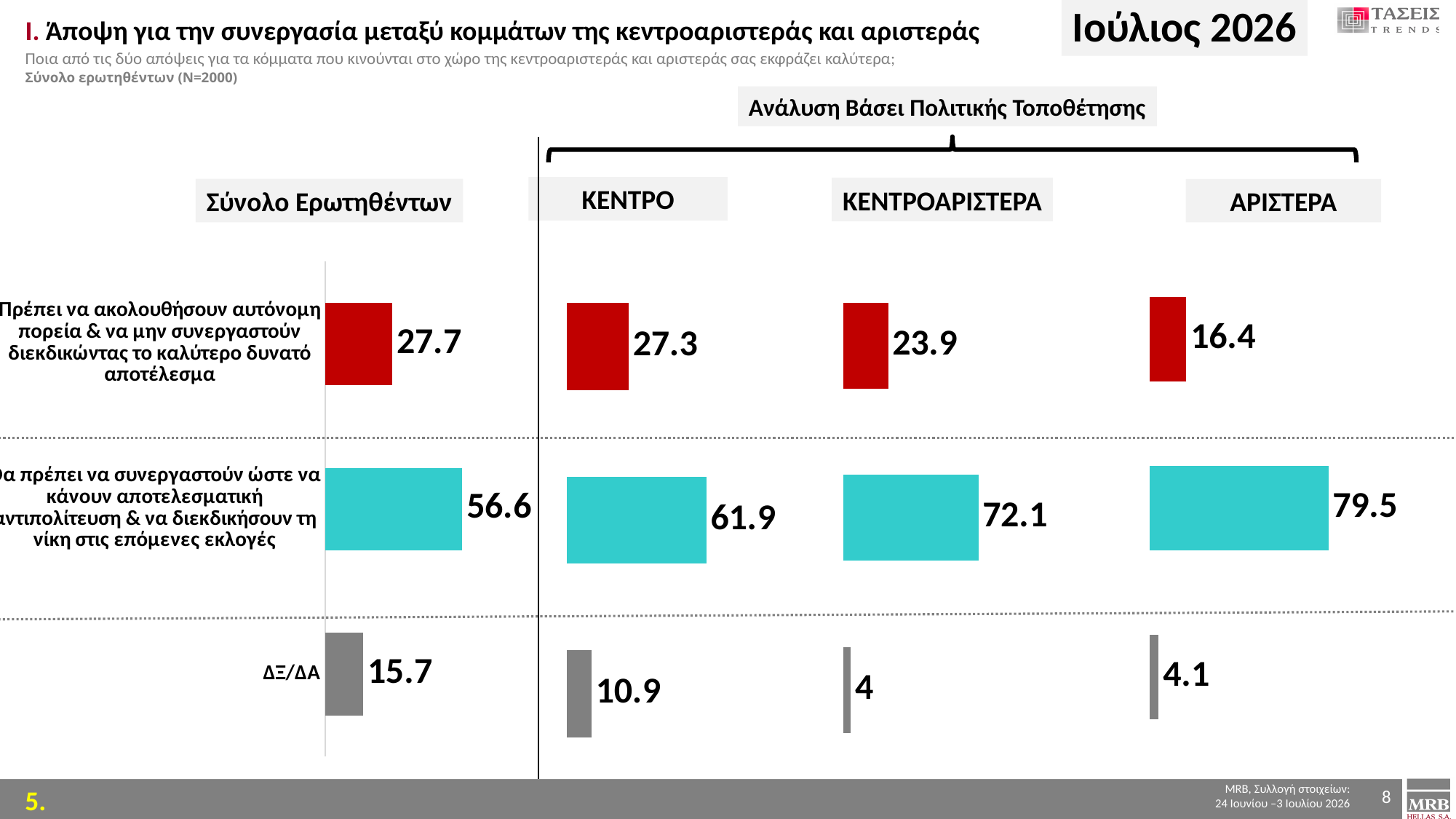
In the "ΚΕΝΤΡΟΑΡΙΣΤΕΡΑ" chart, which category has the highest value? Θα πρέπει να συνεργαστούν ώστε να κάνουν αποτελεσματική αντιπολίτευση & να διεκδικήσουν τη νίκη στις επόμενες εκλογές In the "Σύνολο Ερωτηθέντων" chart, what is the difference between the value for cooperating (56.6) and the value for following an autonomous path (27.7)? 28.9 In the "ΑΡΙΣΤΕΡΑ" chart, what is the value for ΔΞ/ΔΑ? 4.1 What is the difference between the ΔΞ/ΔΑ value in the "Σύνολο Ερωτηθέντων" chart (15.7) and in the "ΚΕΝΤΡΟ" chart (10.9)? 4.8 How many categories are shown in the "ΑΡΙΣΤΕΡΑ" chart? 3 Which is larger: the value for "Πρέπει να ακολουθήσουν αυτόνομη πορεία" in the "ΚΕΝΤΡΟΑΡΙΣΤΕΡΑ" chart or in the "ΑΡΙΣΤΕΡΑ" chart? ΚΕΝΤΡΟΑΡΙΣΤΕΡΑ In the "ΚΕΝΤΡΟ" chart, what is the value for "Πρέπει να ακολουθήσουν αυτόνομη πορεία & να μην συνεργαστούν διεκδικώντας το καλύτερο δυνατό αποτέλεσμα"? 27.3 In the "ΚΕΝΤΡΟ" chart, which category has the lowest value? ΔΞ/ΔΑ In the "ΚΕΝΤΡΟΑΡΙΣΤΕΡΑ" chart, what is the value for ΔΞ/ΔΑ? 4 In the "Σύνολο Ερωτηθέντων" chart, what is the value for "Θα πρέπει να συνεργαστούν ώστε να κάνουν αποτελεσματική αντιπολίτευση & να διεκδικήσουν τη νίκη στις επόμενες εκλογές"? 56.6 What colour are the bars for "Θα πρέπει να συνεργαστούν" across the charts? Turquoise (cyan) What kind of chart is the "Σύνολο Ερωτηθέντων" chart? Bar chart